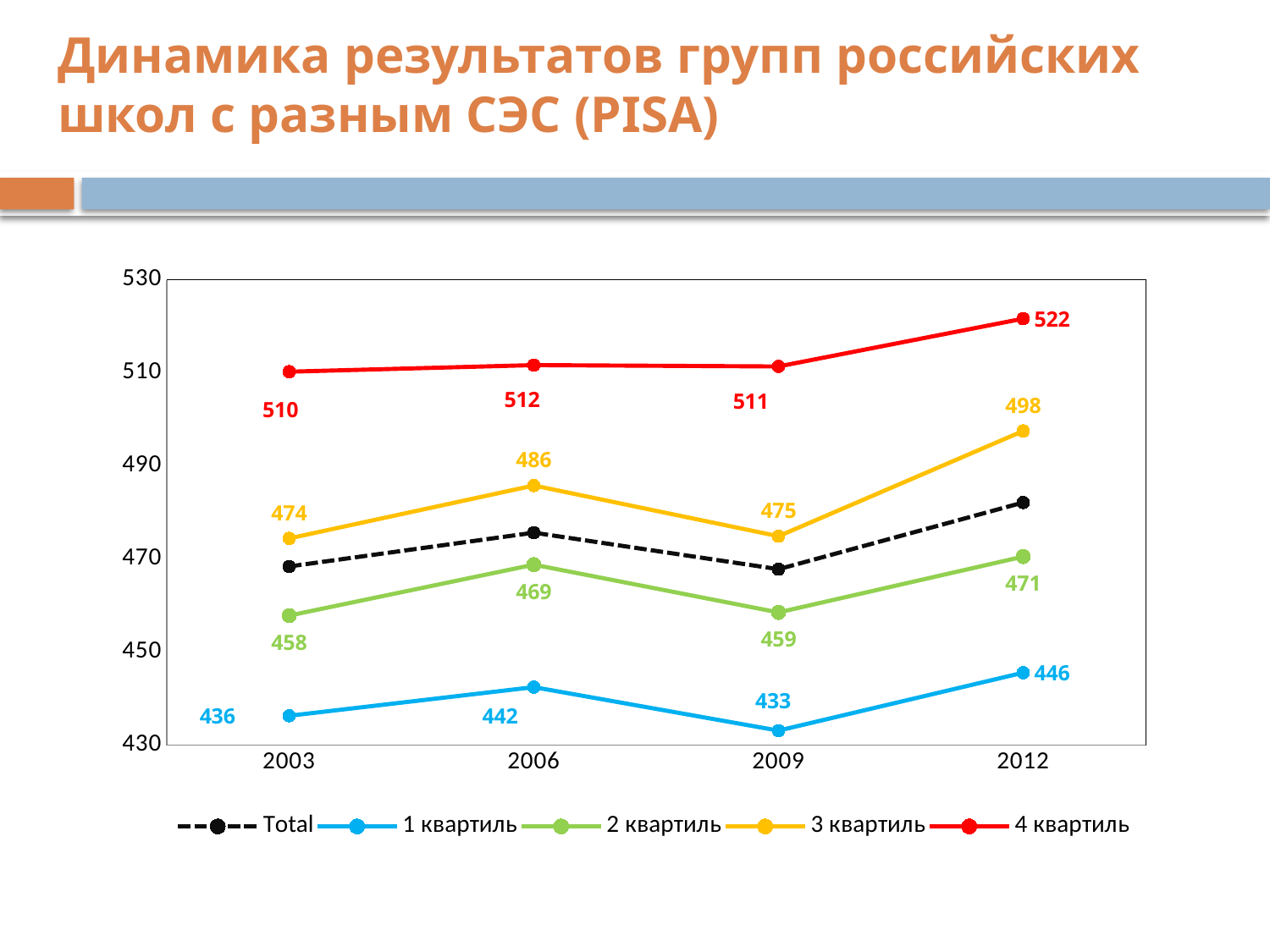
Which is larger: the 2 квартиль value in 2006 or the 2 квартиль value in 2009? 2006 In which year is the value for 1 квартиль lowest? 2009 What is the value for 3 квартиль in 2006? 486 What type of chart is shown on the slide? line chart What is the value for 2 квартиль in 2003? 458 How many years are shown on the x axis? 4 What is the value for 1 квартиль in 2009? 433 What is the difference between the 4 квартиль and 1 квартиль values in 2012? 76 Is the Total value in 2012 greater or less than 470? greater How many series does the legend list? 5 What is the value for 4 квартиль in 2012? 522 In which year is the value for 3 квартиль highest? 2012